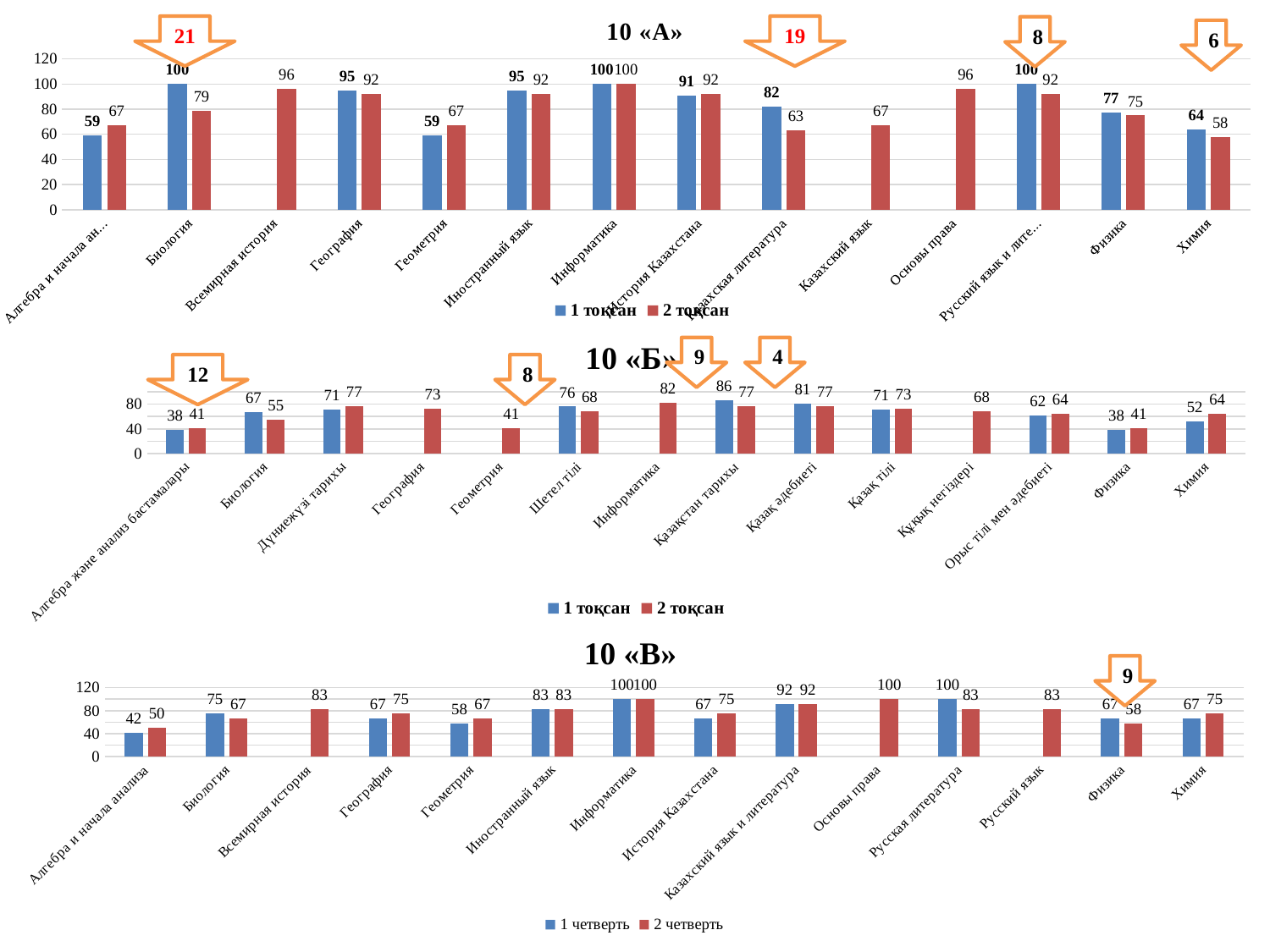
In the 10 «А» chart, which category has the lowest 2 тоқсан value? Химия In the 10 «А» chart, what is the difference between the 1 тоқсан and 2 тоқсан values for Казахская литература? 19 In the 10 «В» chart, what are the two legend entries? 1 четверть and 2 четверть In the 10 «Б» chart, is the 1 тоқсан value for Биология larger or the 2 тоқсан value? 1 тоқсан In the 10 «В» chart, what is the difference between the 1 четверть and 2 четверть values for Русская литература? 17 In the 10 «Б» chart, how many categories are shown on the x axis? 14 In the 10 «А» chart, how many series does the legend list? 2 What kind of chart is the 10 «В» chart? Bar chart In the 10 «Б» chart, what is the 1 тоқсан value for Қазақстан тарихы? 86 In the 10 «Б» chart, which category has the highest 2 тоқсан value? Информатика In the 10 «В» chart, what is the 2 четверть value for Основы права? 100 In the 10 «А» chart, what is the value of 2 тоқсан for Биология? 79